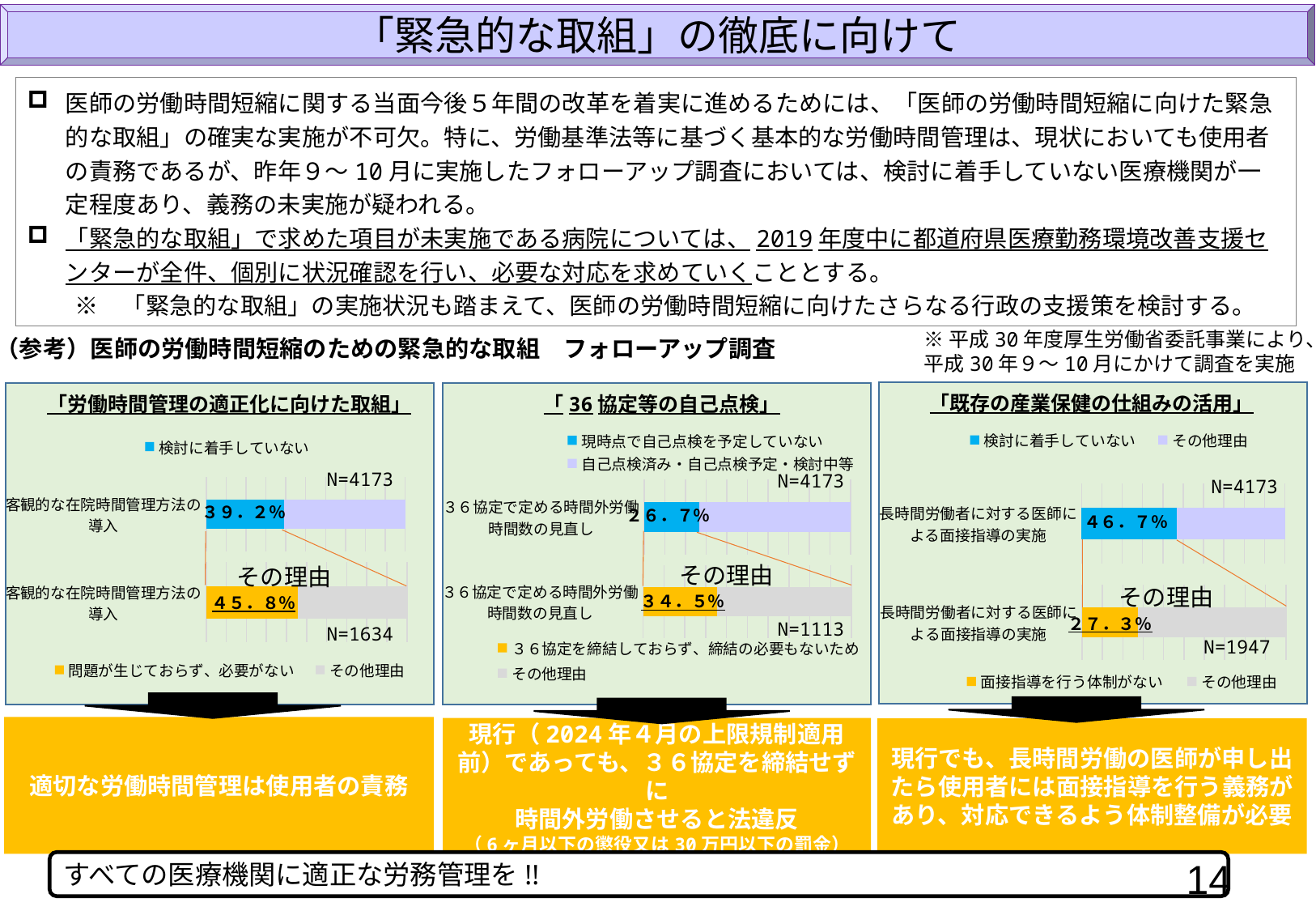
In the chart titled 「36協定等の自己点検」, what percentage is shown for 36協定を締結しておらず、締結の必要もないため? 34.5% In the chart titled 「既存の産業保健の仕組みの活用」, what percentage is shown for 検討に着手していない? 46.7% In the chart titled 「労働時間管理の適正化に向けた取組」, what percentage is shown for 問題が生じておらず、必要がない? 45.8% What is the difference between the blue-bar percentage in 「既存の産業保健の仕組みの活用」 (46.7%) and in 「労働時間管理の適正化に向けた取組」 (39.2%)? 7.5% In the chart titled 「既存の産業保健の仕組みの活用」, what is the N value for the bottom bar (その理由)? N=1947 In the chart titled 「既存の産業保健の仕組みの活用」, what percentage is shown for 面接指導を行う体制がない? 27.3% In the chart titled 「36協定等の自己点検」, what is the N value for the bottom bar (その理由)? N=1113 What type of chart is used in the three panels of the フォローアップ調査 section? Bar chart Across the three charts, which chart shows the highest percentage for the top (blue) bar? 「既存の産業保健の仕組みの活用」 In the chart titled 「労働時間管理の適正化に向けた取組」, what percentage is shown for 検討に着手していない? 39.2% In the chart titled 「36協定等の自己点検」, what percentage is shown for 現時点で自己点検を予定していない? 26.7% Across the three charts, which chart shows the lowest percentage for the top (blue) bar? 「36協定等の自己点検」